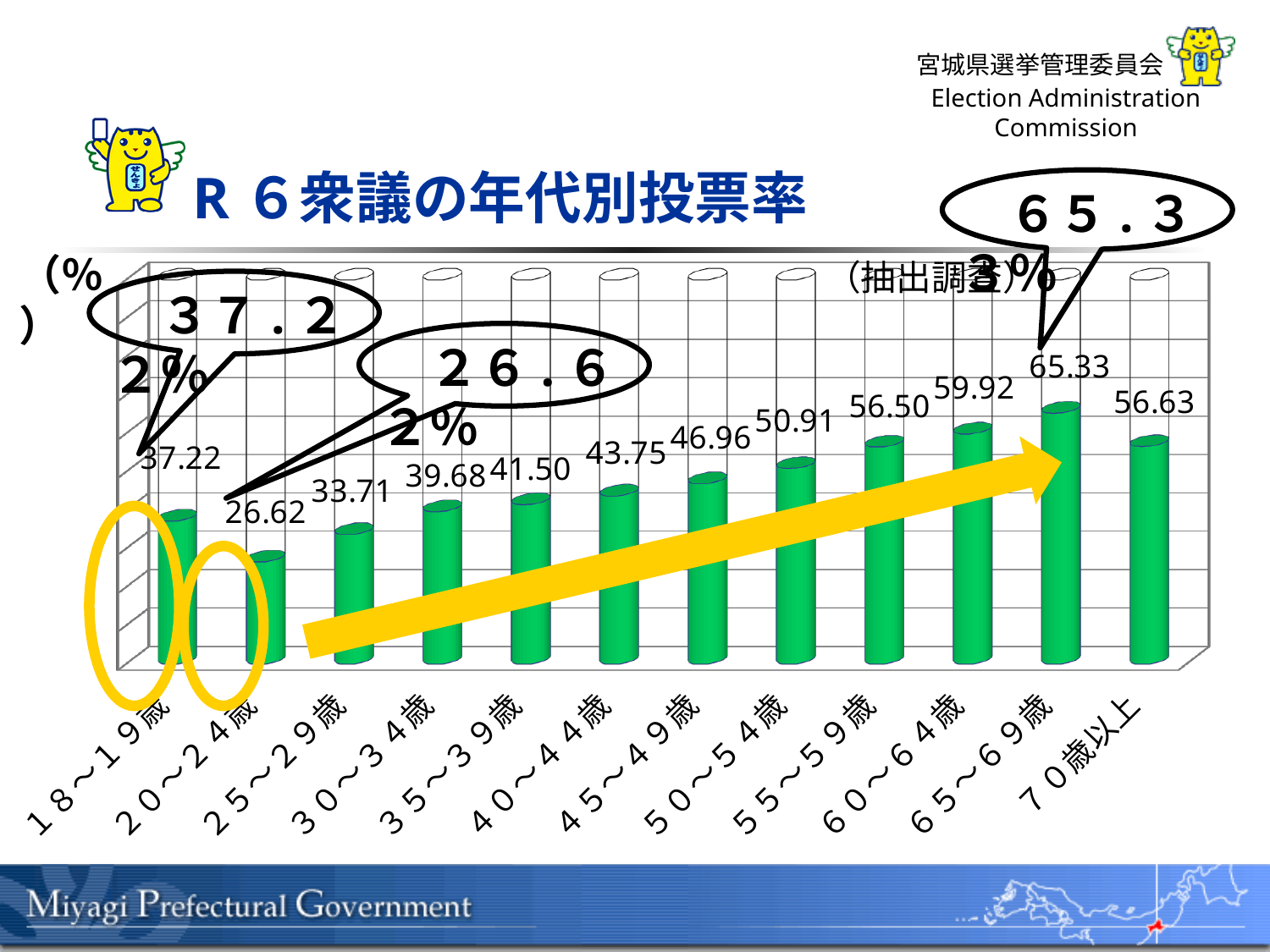
What is the difference between the values for 65～69歳 and 20～24歳? 38.71 Which has a higher value, 60～64歳 or 70歳以上? 60～64歳 Do the values generally rise or fall from 20～24歳 to 65～69歳? Rise Which age group has the highest voter turnout? 65～69歳 What is the value shown for the 70歳以上 age group? 56.63 How many age groups are shown on the chart? 12 What is the difference between the values for 18～19歳 and 20～24歳? 10.60 What is the voter turnout value shown for the 18～19歳 age group? 37.22 What is the value shown for the 45～49歳 age group? 46.96 What is the voter turnout value shown for the 20～24歳 age group? 26.62 What kind of chart is shown on the slide? Bar chart Which age group has the lowest voter turnout? 20～24歳